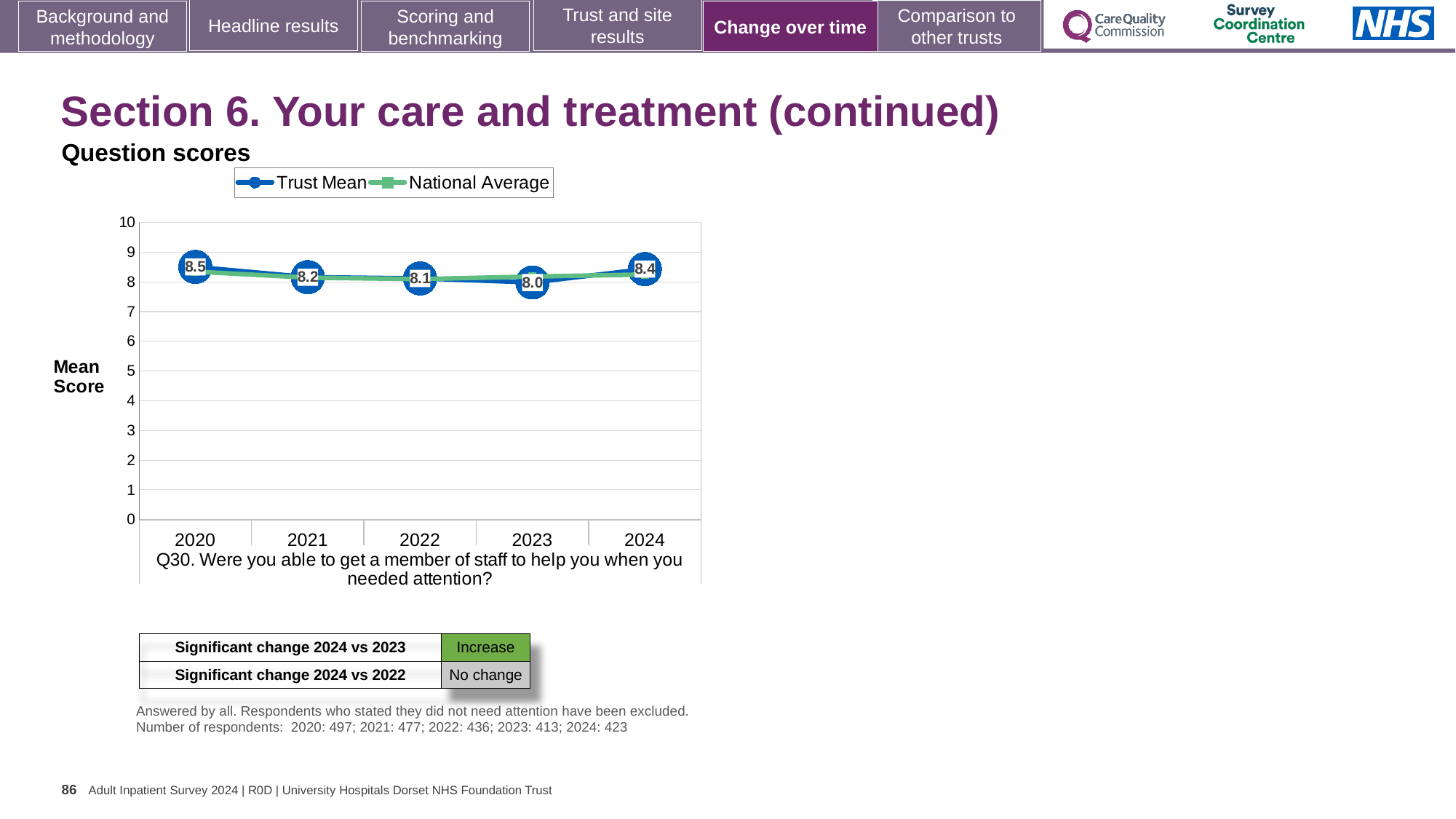
What kind of chart is shown? Line chart How many years are plotted on the x axis? 5 What is the difference between the Trust Mean in 2020 and in 2023? 0.5 Does the Trust Mean rise or fall from 2020 to 2023? Fall What is the Trust Mean value for 2024? 8.4 What is the Trust Mean value for 2023? 8.0 In which year is the Trust Mean lowest? 2023 What is the Trust Mean value for 2020? 8.5 In which year is the Trust Mean highest? 2020 How many series does the legend list? 2 Which year has the larger Trust Mean, 2021 or 2024? 2024 Is the National Average value for 2022 greater or less than 5? greater